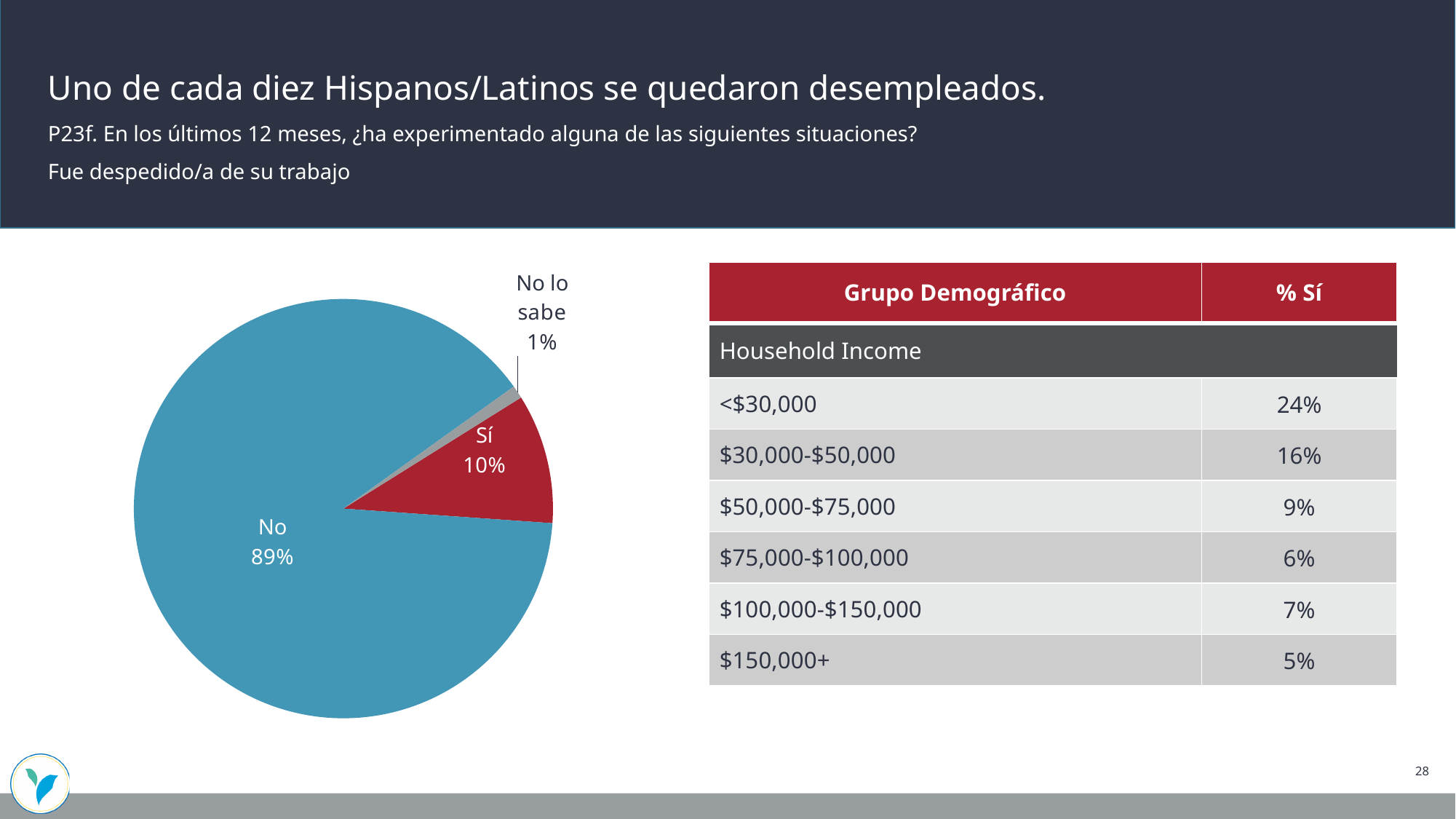
What colour is the "No" slice of the pie chart? Blue What type of chart is shown on the slide? Pie chart What share of the pie chart is labelled "Sí"? 10% What share of the pie chart is labelled "No"? 89% What is the difference in percentage points between the "No" slice and the "Sí" slice? 79 Which slice of the pie chart is the largest? No Which slice of the pie chart is the smallest? No lo sabe Which is larger in the pie chart, the "Sí" slice or the "No lo sabe" slice? Sí What share of the pie chart is labelled "No lo sabe"? 1% How many slices does the pie chart have? 3 What colour is the "Sí" slice of the pie chart? Red